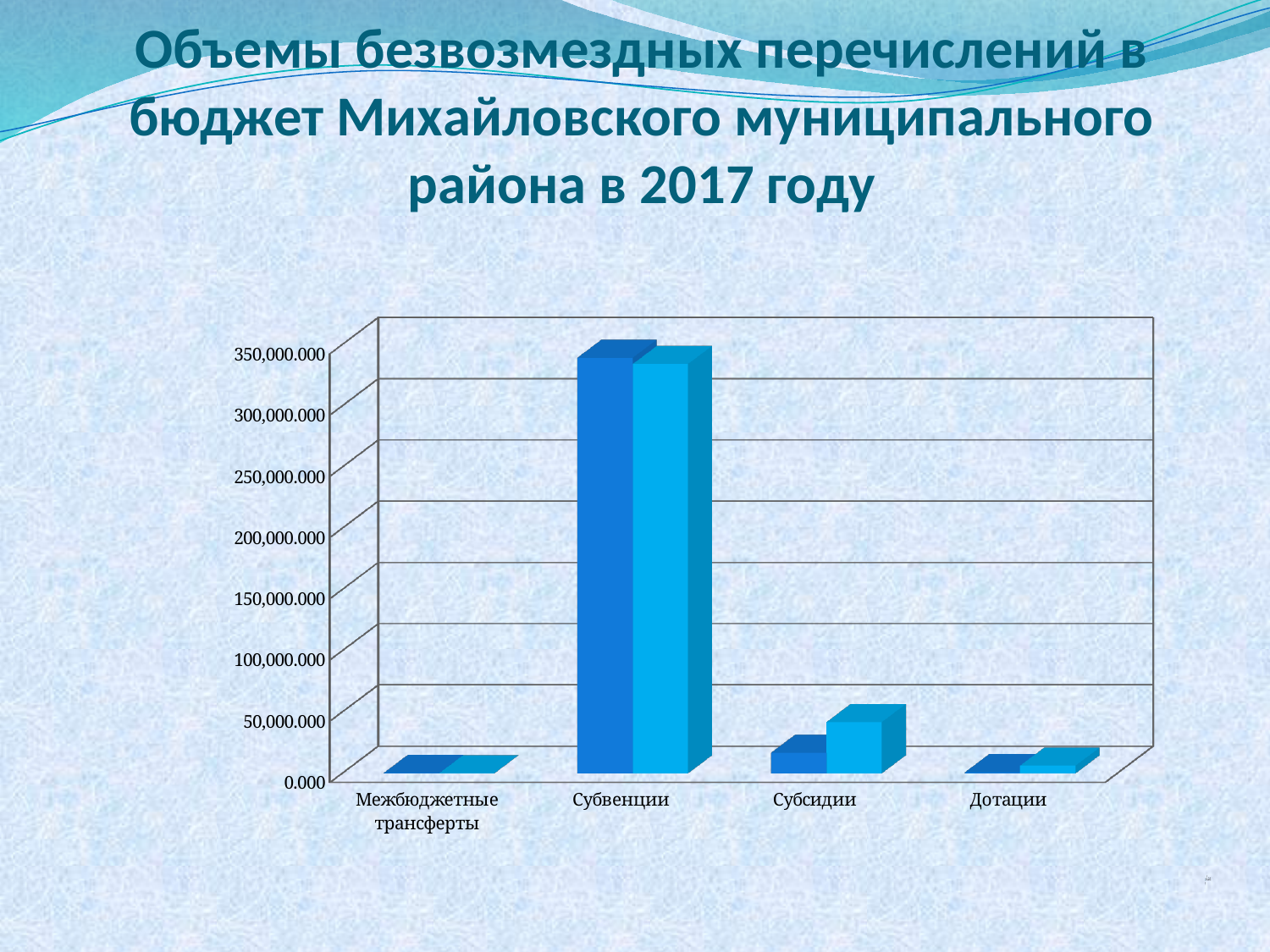
Are the values for Субсидии greater or less than 100,000.000? less Are the values for Субвенции greater or less than 300,000.000? greater Are the values for Дотации greater or less than 50,000.000? less Which category has larger values, Субсидии or Межбюджетные трансферты? Субсидии Do the values rise steadily from left to right across the categories? No What is the highest value shown on the y axis of the chart? 350,000.000 How many categories are shown on the x axis of the chart? 4 What kind of chart is shown on the slide? bar chart Which category has larger values, Субвенции or Субсидии? Субвенции What is the title of the slide containing the chart? Объемы безвозмездных перечислений в бюджет Михайловского муниципального района в 2017 году Which category has the highest bars in the chart? Субвенции